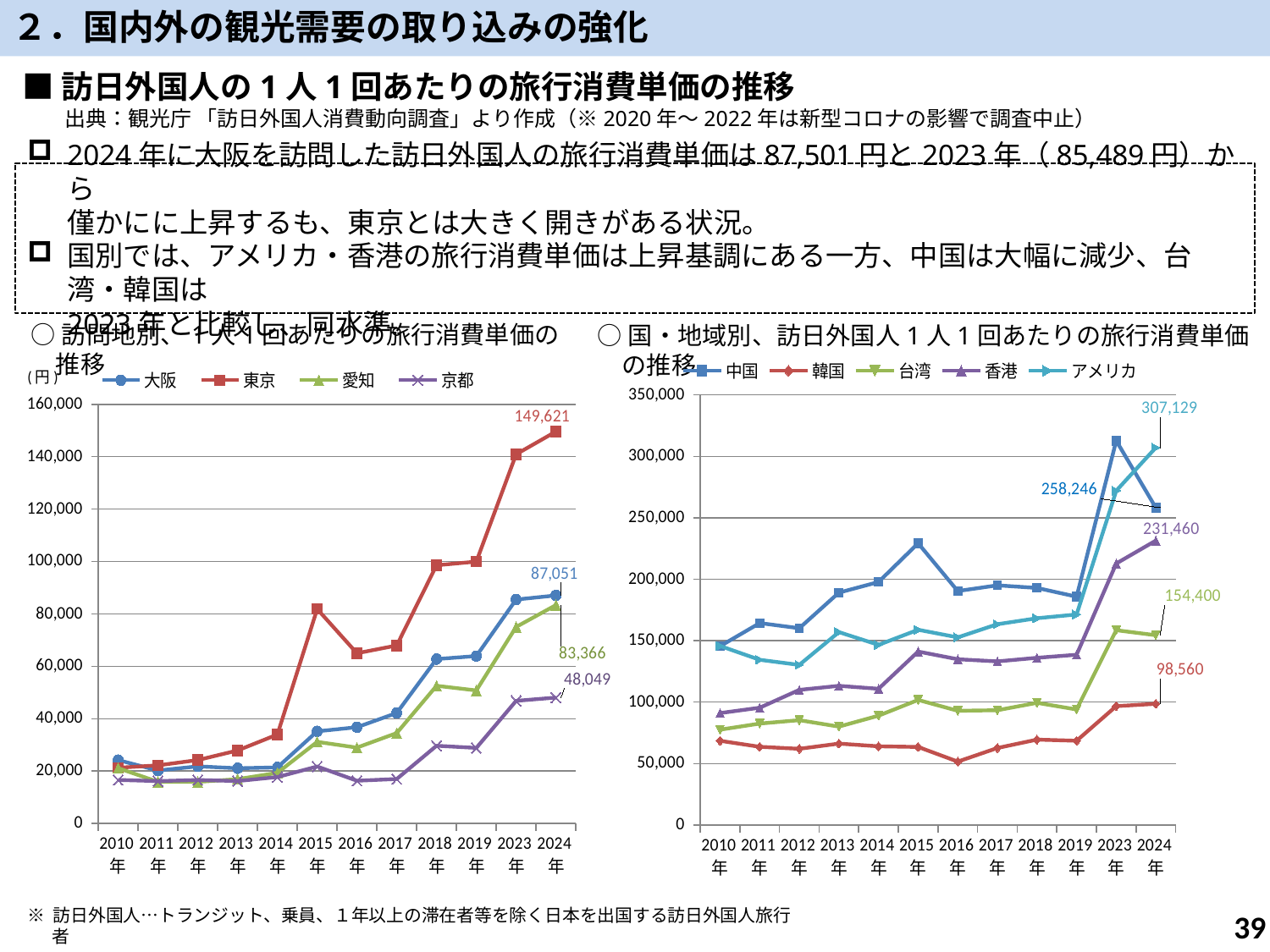
On the right chart (国・地域別), which series has the lowest value in 2024年? 韓国 How many series does the legend of the right chart (国・地域別) list? 5 On the right chart (国・地域別), what is the value for アメリカ in 2024年? 307,129 On the right chart (国・地域別), is the value for 中国 in 2015年 greater or less than 200,000? greater On the left chart (訪問地別), what is the difference between the 2024年 values for 東京 and 大阪? 62,570 On the left chart (訪問地別), what is the value for 東京 in 2024年? 149,621 On the left chart (訪問地別), what is the value for 大阪 in 2024年? 87,051 On the right chart (国・地域別), what is the value for 韓国 in 2024年? 98,560 On the left chart (訪問地別), which series has the highest value in 2024年? 東京 What kind of chart is the left chart (訪問地別)? line chart On the right chart (国・地域別), which is larger in 2024年, 香港 or 台湾? 香港 How many years are shown on the x axis of the left chart (訪問地別)? 12